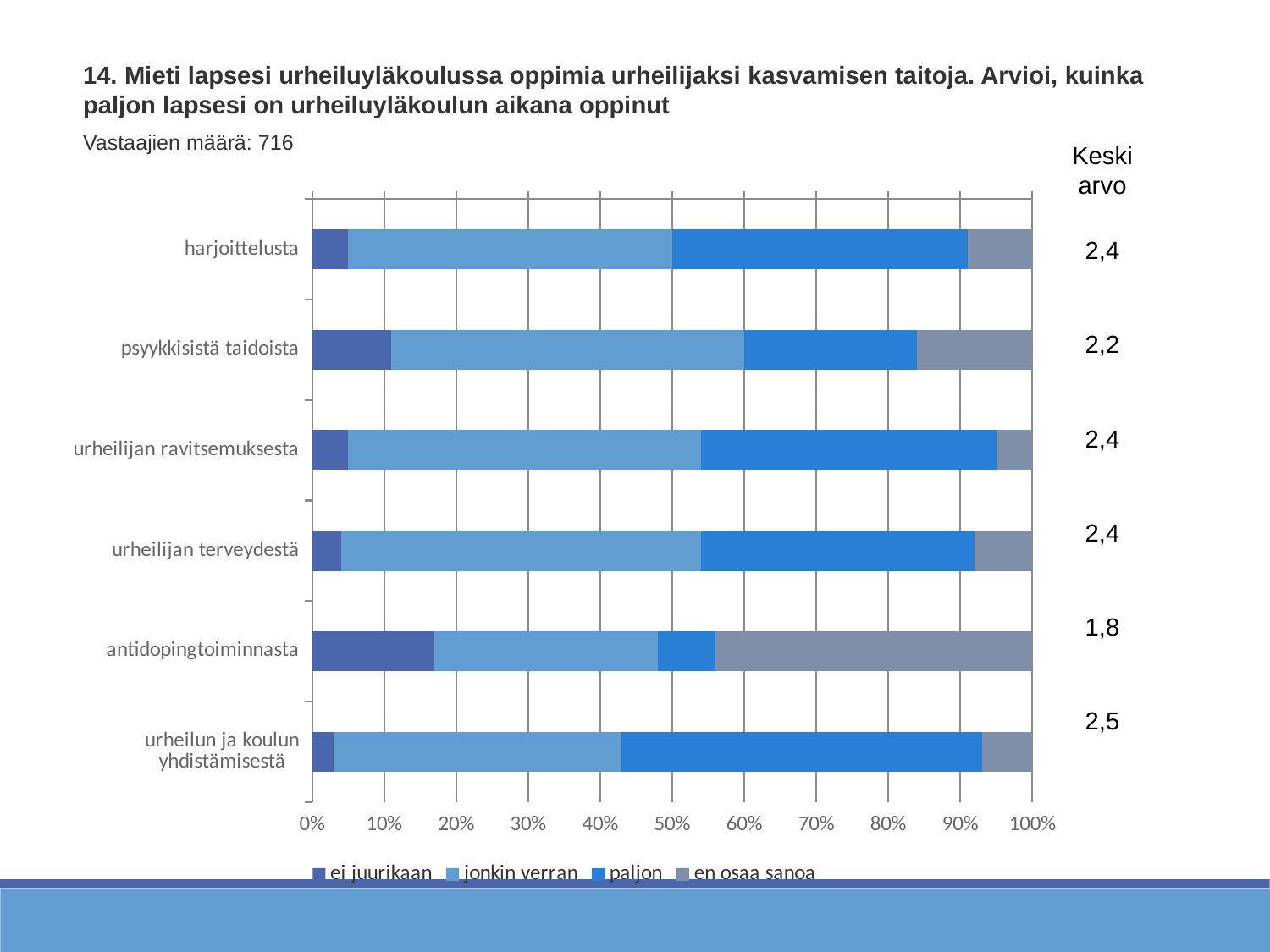
What kind of chart is shown on the slide? bar chart Is the 'jonkin verran' value for psyykkisistä taidoista greater or less than 40%? greater Which category has the smallest 'paljon' segment? antidopingtoiminnasta Is the 'en osaa sanoa' value for antidopingtoiminnasta greater or less than 40%? greater How many series does the legend list? 4 Which category has the largest 'en osaa sanoa' segment? antidopingtoiminnasta Which has the larger 'ei juurikaan' segment, psyykkisistä taidoista or harjoittelusta? psyykkisistä taidoista How many categories are plotted on the chart? 6 What is the last entry in the chart's legend? en osaa sanoa What is the 'Keski arvo' (mean) shown for antidopingtoiminnasta? 1,8 Which category has the largest 'paljon' segment? urheilun ja koulun yhdistämisestä